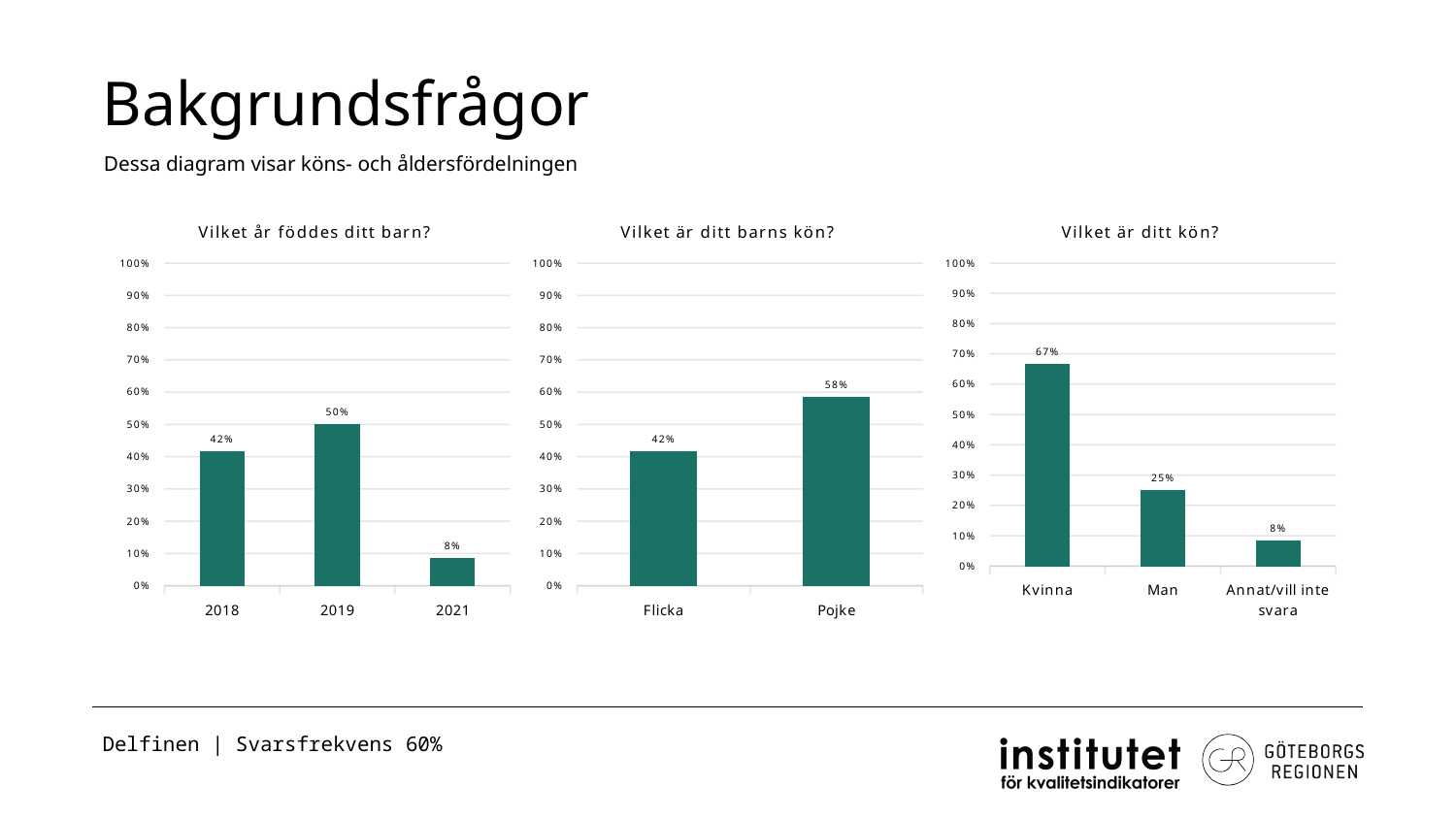
In the chart 'Vilket år föddes ditt barn?', what is the difference between the values for 2019 and 2018? 8% How many charts are shown on the slide? 3 In the chart 'Vilket är ditt kön?', which category has the highest value? Kvinna In the chart 'Vilket år föddes ditt barn?', what is the value for 2019? 50% In the chart 'Vilket är ditt barns kön?', which is larger, Flicka or Pojke? Pojke In the chart 'Vilket år föddes ditt barn?', how many categories are shown on the x axis? 3 In the chart 'Vilket är ditt kön?', what is the value for Man? 25% In the chart 'Vilket är ditt barns kön?', what is the difference between Pojke and Flicka? 16% What kind of chart is 'Vilket är ditt kön?'? Bar chart In the chart 'Vilket är ditt kön?', what is the value for Annat/vill inte svara? 8% In the chart 'Vilket år föddes ditt barn?', which category has the lowest value? 2021 In the chart 'Vilket är ditt barns kön?', what is the value for Pojke? 58%